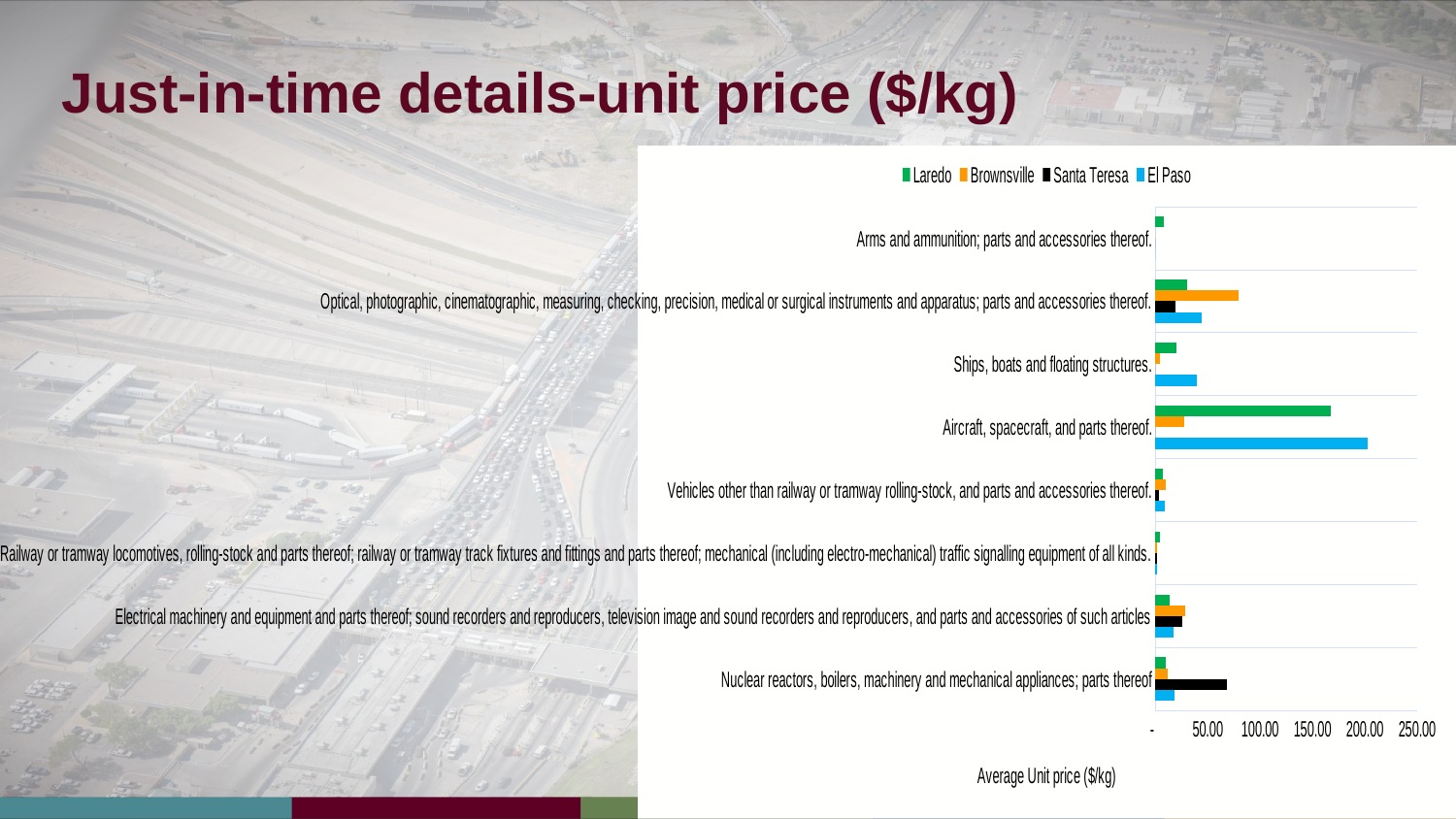
Is the Brownsville value for 'Optical, photographic, cinematographic, measuring, checking, precision, medical or surgical instruments and apparatus; parts and accessories thereof.' greater or less than 50.00? greater How many product categories are plotted on the chart? 8 What kind of chart is shown on the slide? bar chart Which series has the highest value for 'Optical, photographic, cinematographic, measuring, checking, precision, medical or surgical instruments and apparatus; parts and accessories thereof.'? Brownsville Which series has the highest value for 'Nuclear reactors, boilers, machinery and mechanical appliances; parts thereof'? Santa Teresa For 'Aircraft, spacecraft, and parts thereof.', which is larger: the El Paso value or the Laredo value? El Paso Which series has the highest value for 'Aircraft, spacecraft, and parts thereof.'? El Paso Is the El Paso value for 'Ships, boats and floating structures.' greater or less than 100.00? less How many series does the legend list? 4 Is the El Paso value for 'Aircraft, spacecraft, and parts thereof.' greater or less than 150.00? greater What is the title of the horizontal axis? Average Unit price ($/kg)